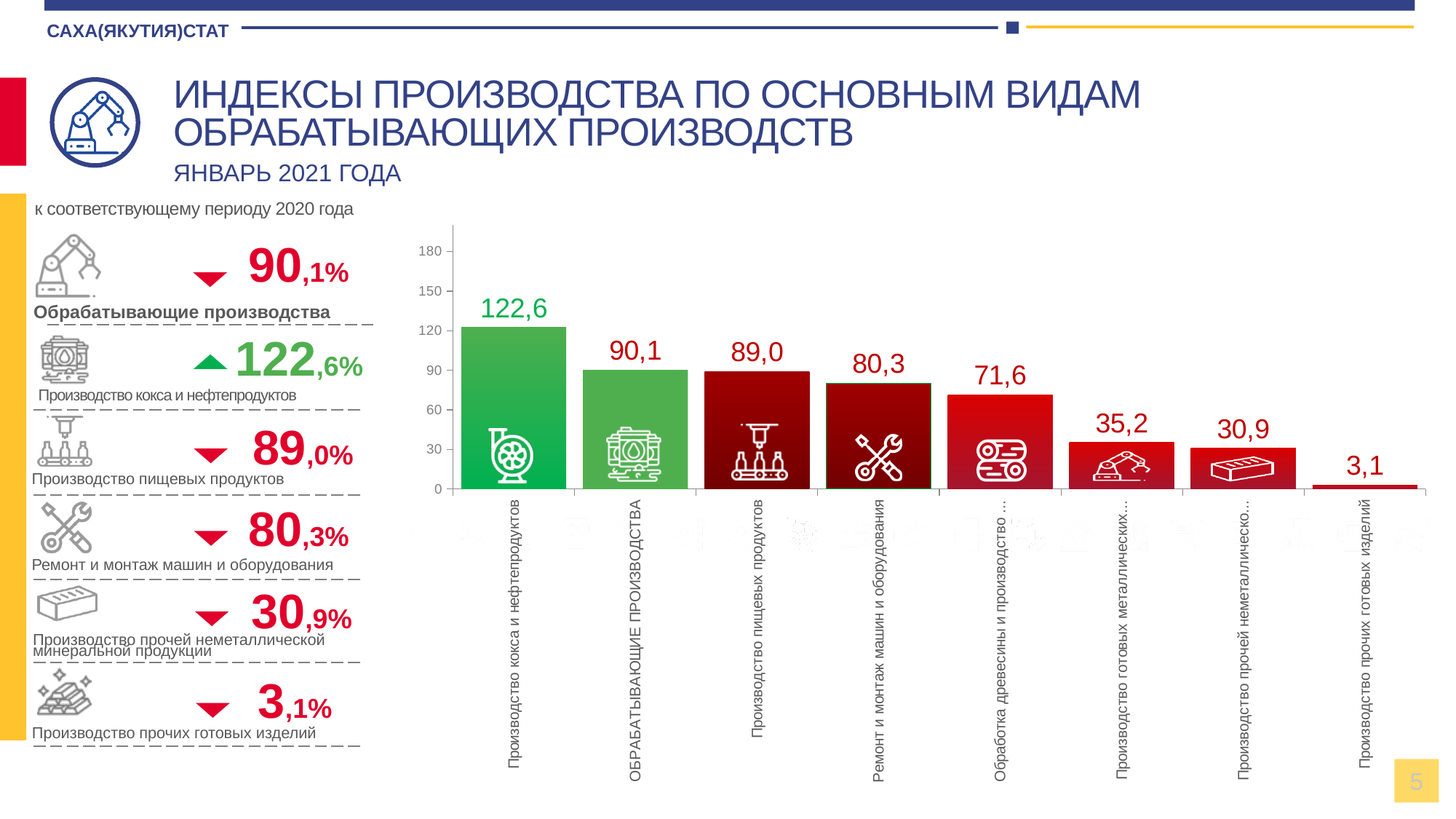
Is the value for ОБРАБАТЫВАЮЩИЕ ПРОИЗВОДСТВА greater or less than 120? less How many bars are plotted in the chart? 8 Which category has the lowest value in the chart? Производство прочих готовых изделий What is the value for Ремонт и монтаж машин и оборудования in the chart? 80,3 Do the bar values rise or fall from left to right along the x axis? fall Which is larger: the value for Производство пищевых продуктов or the value for Ремонт и монтаж машин и оборудования? Производство пищевых продуктов What is the difference between the values for Производство кокса и нефтепродуктов and ОБРАБАТЫВАЮЩИЕ ПРОИЗВОДСТВА? 32,5 What is the value for Производство пищевых продуктов in the chart? 89,0 Which category has the highest value in the chart? Производство кокса и нефтепродуктов What is the value for Производство кокса и нефтепродуктов in the chart? 122,6 What is the value for Производство прочих готовых изделий in the chart? 3,1 What type of chart is shown on the slide? bar chart